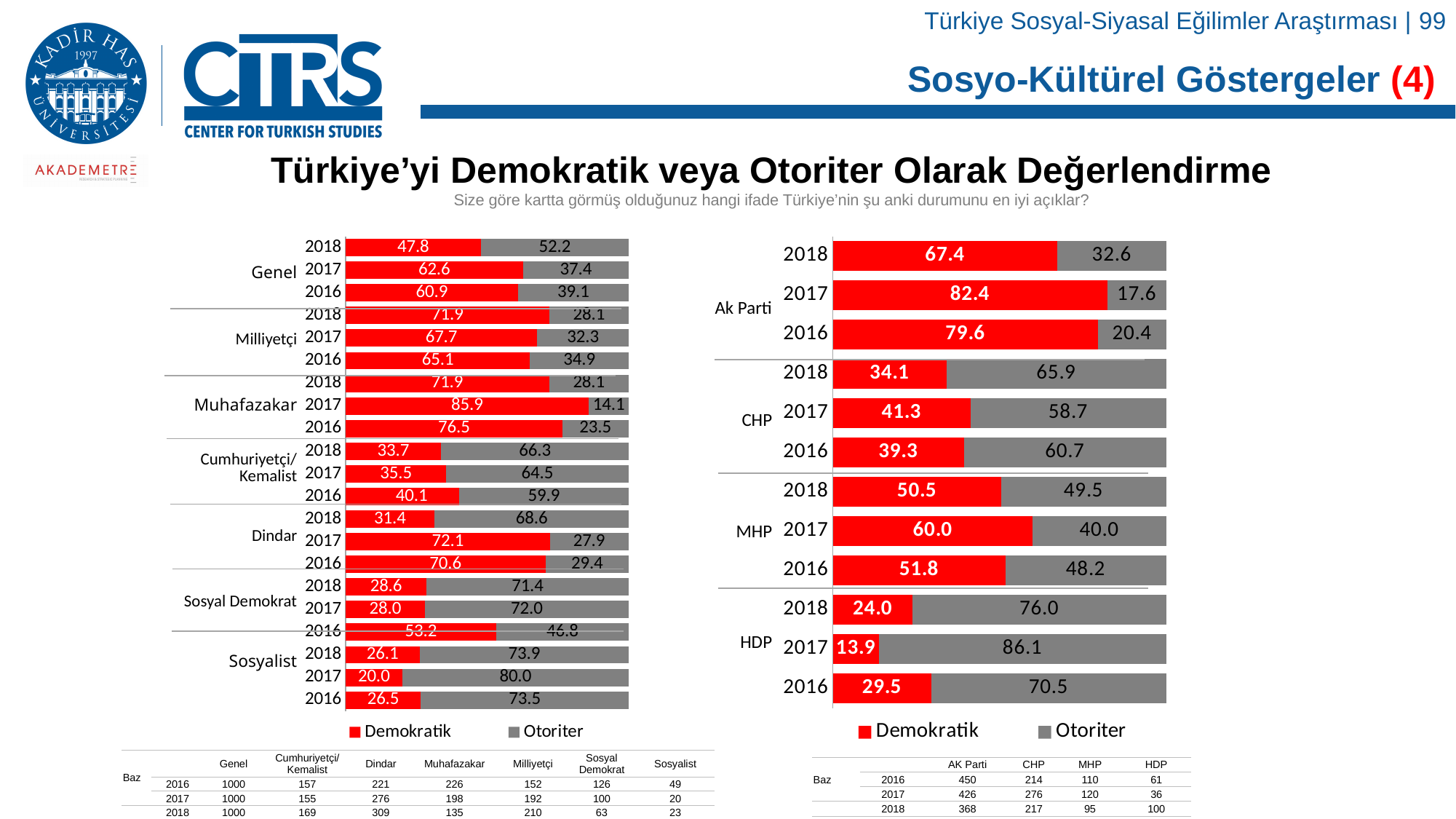
How many series does the legend of the right chart list? 2 In the left chart, what is the Demokratik value for Genel in 2018? 47.8 In the right chart, what is the Demokratik value for HDP in 2017? 13.9 In the left chart, which group and year has the highest Demokratik value? Muhafazakar 2017 In the right chart, what is the Otoriter value for CHP in 2017? 58.7 In the left chart, which is larger: the Demokratik value for Dindar in 2017 or for Dindar in 2018? Dindar 2017 What type of chart is the right chart? Stacked bar chart In the left chart, which colour represents the Otoriter series? Grey In the left chart, how many groups (categories) are shown? 7 In the right chart, what is the difference between the Demokratik values for Ak Parti in 2017 and 2018? 15.0 In the right chart, what is the total of the stacked bar for MHP in 2016? 100.0 In the right chart, which party and year has the lowest Demokratik value? HDP 2017